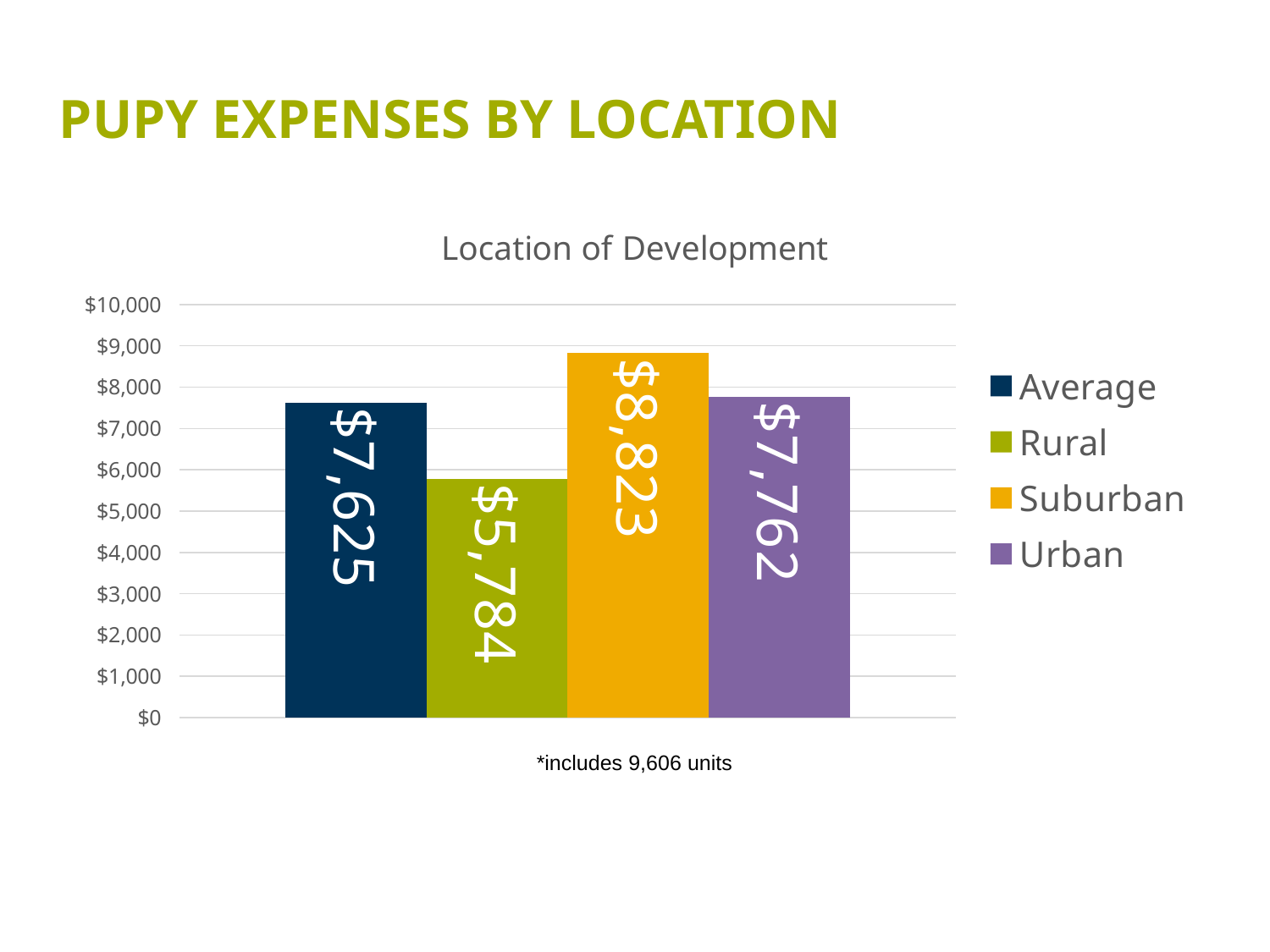
What is the value for Urban? $7,762 Which location has the highest value? Suburban What is the value for Suburban? $8,823 Which is larger, the value for Suburban or the value for Urban? Suburban What is the difference between the Urban and Average values? $137 What kind of chart is shown on the slide? Bar chart Which location has the lowest value? Rural What is the difference between the Suburban and Rural values? $3,039 What is the value for Rural? $5,784 How many series does the legend list? 4 What is the value for Average? $7,625 What is the title of the chart? Location of Development